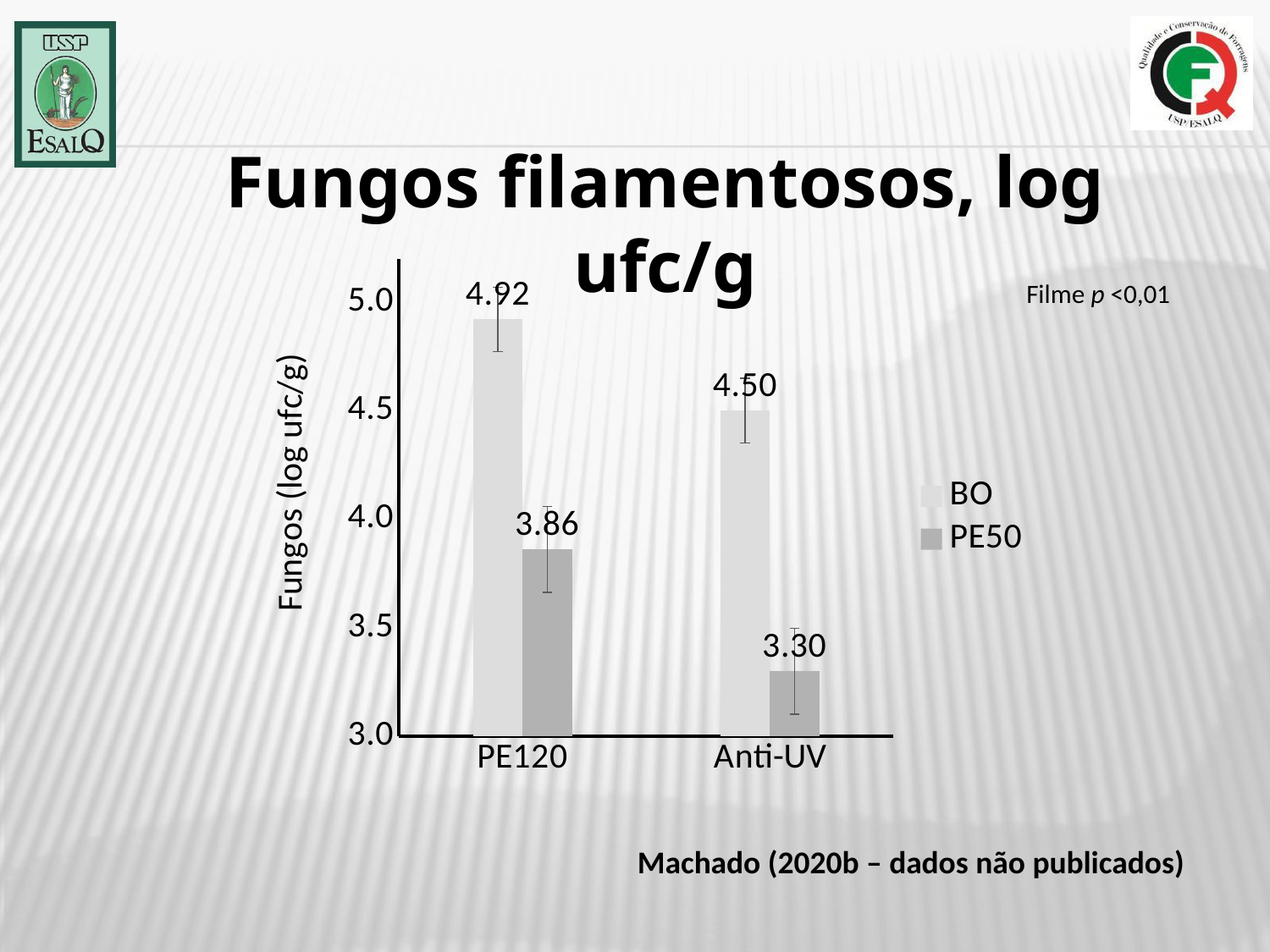
Which bar has the lowest value on the chart? PE50 in Anti-UV Which bar has the highest value on the chart? BO in PE120 How many series does the legend list? 2 What is the value for BO in the Anti-UV category? 4.50 How many categories are shown on the x axis? 2 What kind of chart is shown on the slide? Bar chart What is the difference between the BO values for PE120 and Anti-UV? 0.42 What is the difference between the BO and PE50 values in the PE120 category? 1.06 What is the value for PE50 in the Anti-UV category? 3.30 Which is larger, the PE50 value for PE120 or the PE50 value for Anti-UV? PE50 for PE120 What is the value for BO in the PE120 category? 4.92 What is the value for PE50 in the PE120 category? 3.86